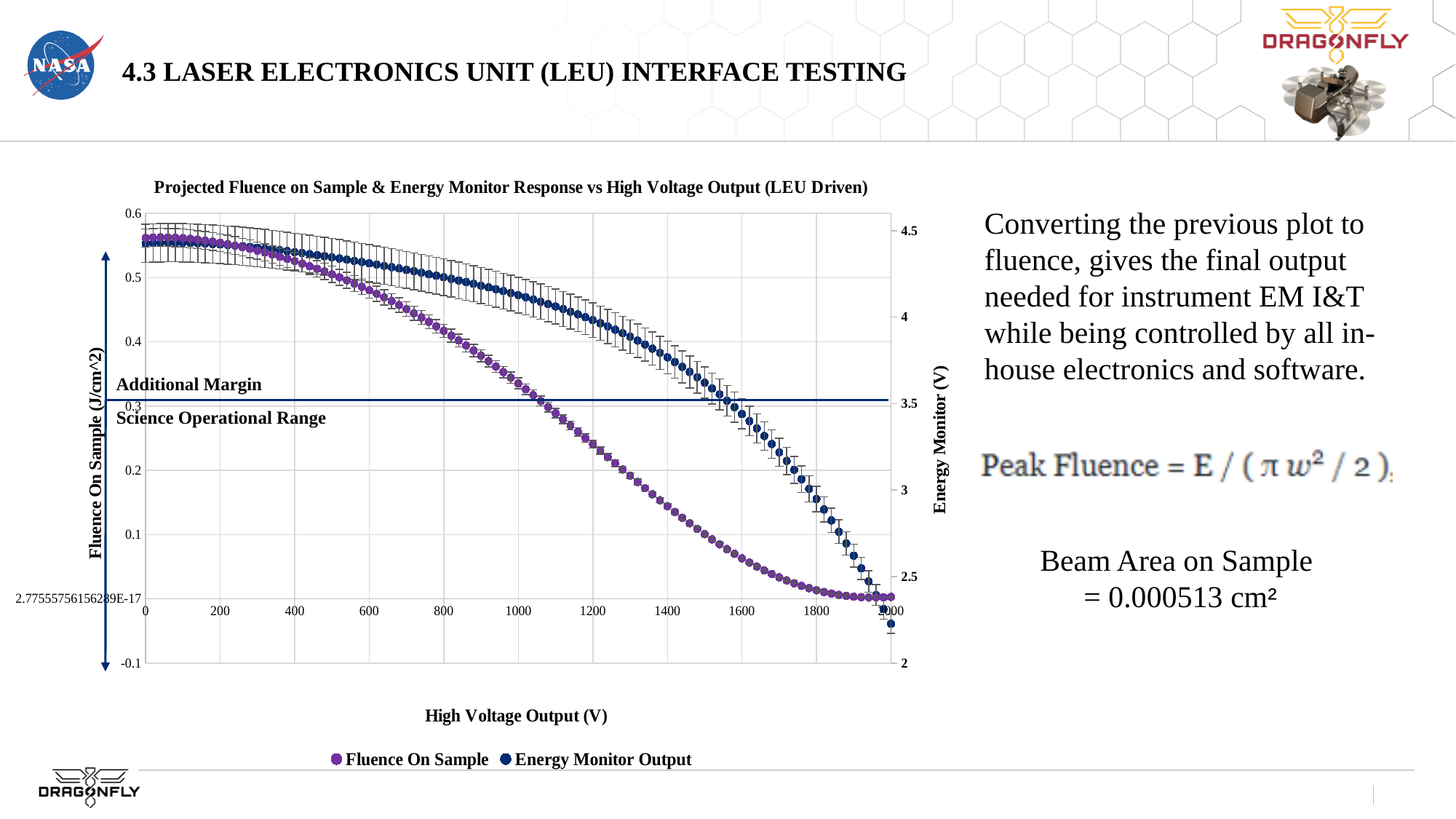
Does the Fluence On Sample series rise or fall as High Voltage Output increases? fall Is the Energy Monitor Output value at 0 V greater or less than 4? greater Which is larger, the Fluence On Sample value at 200 V or at 1600 V? 200 V How many series does the legend list? 2 Is the Fluence On Sample value at 0 V greater or less than 0.5? greater What kind of chart is shown on the slide? scatter chart Is the Fluence On Sample value at 600 V greater or less than 0.4? greater What is the title of the chart? Projected Fluence on Sample & Energy Monitor Response vs High Voltage Output (LEU Driven) What is the label of the x axis? High Voltage Output (V) Does the Energy Monitor Output series rise or fall as High Voltage Output increases? fall